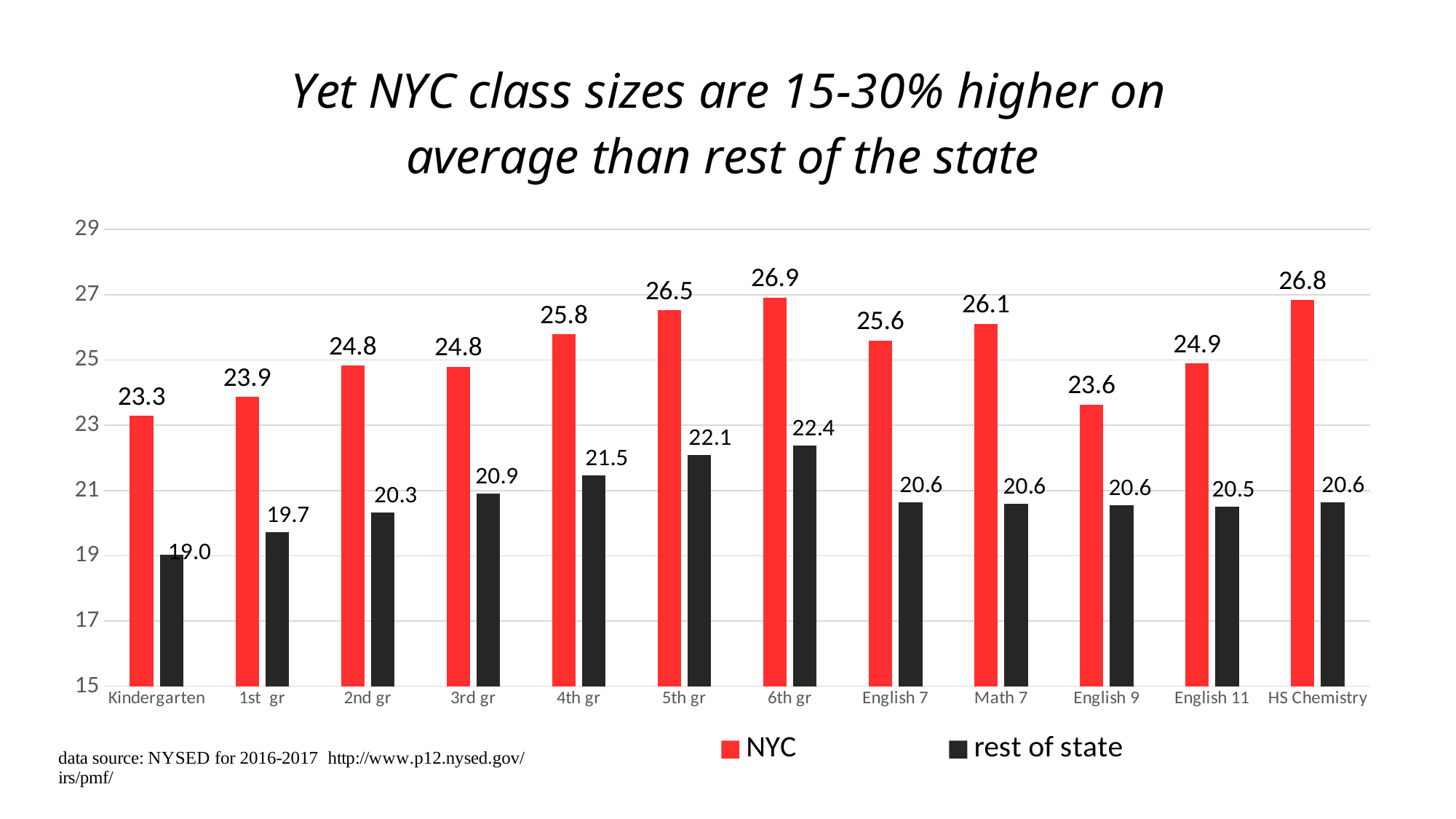
Is the rest of state value for 5th gr greater or less than 21? greater Which category has the lowest rest of state class size? Kindergarten Which category has the highest NYC class size? 6th gr How many series does the legend list? 2 What is the difference between the NYC and rest of state values for 4th gr? 4.3 What kind of chart is shown on the slide? bar chart What is the NYC value for HS Chemistry? 26.8 What is the rest of state average class size for Kindergarten? 19.0 How many categories are shown on the x axis? 12 Which colour represents the NYC series? red Which is larger, the NYC value for English 9 or the NYC value for English 11? English 11 What is the NYC average class size for 6th gr? 26.9